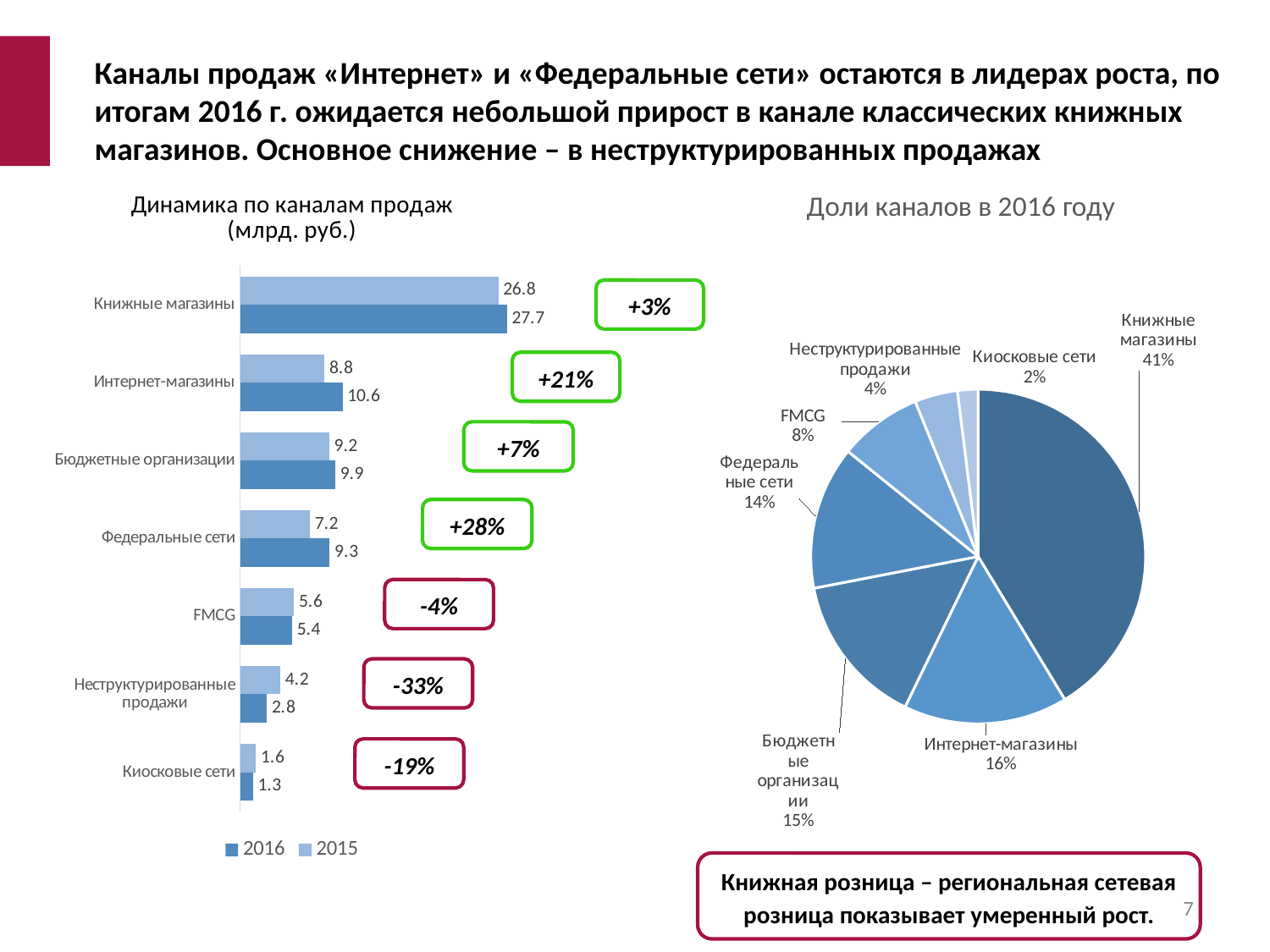
How many categories are shown in the chart «Динамика по каналам продаж (млрд. руб.)»? 7 What type of chart is «Доли каналов в 2016 году»? Pie chart In the chart «Динамика по каналам продаж (млрд. руб.)», what is the 2015 value for Федеральные сети? 7.2 What type of chart is «Динамика по каналам продаж (млрд. руб.)»? Bar chart In the pie chart «Доли каналов в 2016 году», which slice is the largest? Книжные магазины In the chart «Динамика по каналам продаж (млрд. руб.)», what is the difference between the 2016 and 2015 values for Неструктурированные продажи? 1.4 In the chart «Динамика по каналам продаж (млрд. руб.)», which category has the highest 2016 value? Книжные магазины In the chart «Динамика по каналам продаж (млрд. руб.)», what is the 2016 value for Интернет-магазины? 10.6 In the chart «Динамика по каналам продаж (млрд. руб.)», which is larger for FMCG: the 2016 value or the 2015 value? 2015 In the chart «Динамика по каналам продаж (млрд. руб.)», which category has the lowest 2015 value? Киосковые сети In the pie chart «Доли каналов в 2016 году», what share does Федеральные сети have? 14% How many series does the legend of the chart «Динамика по каналам продаж (млрд. руб.)» list? 2